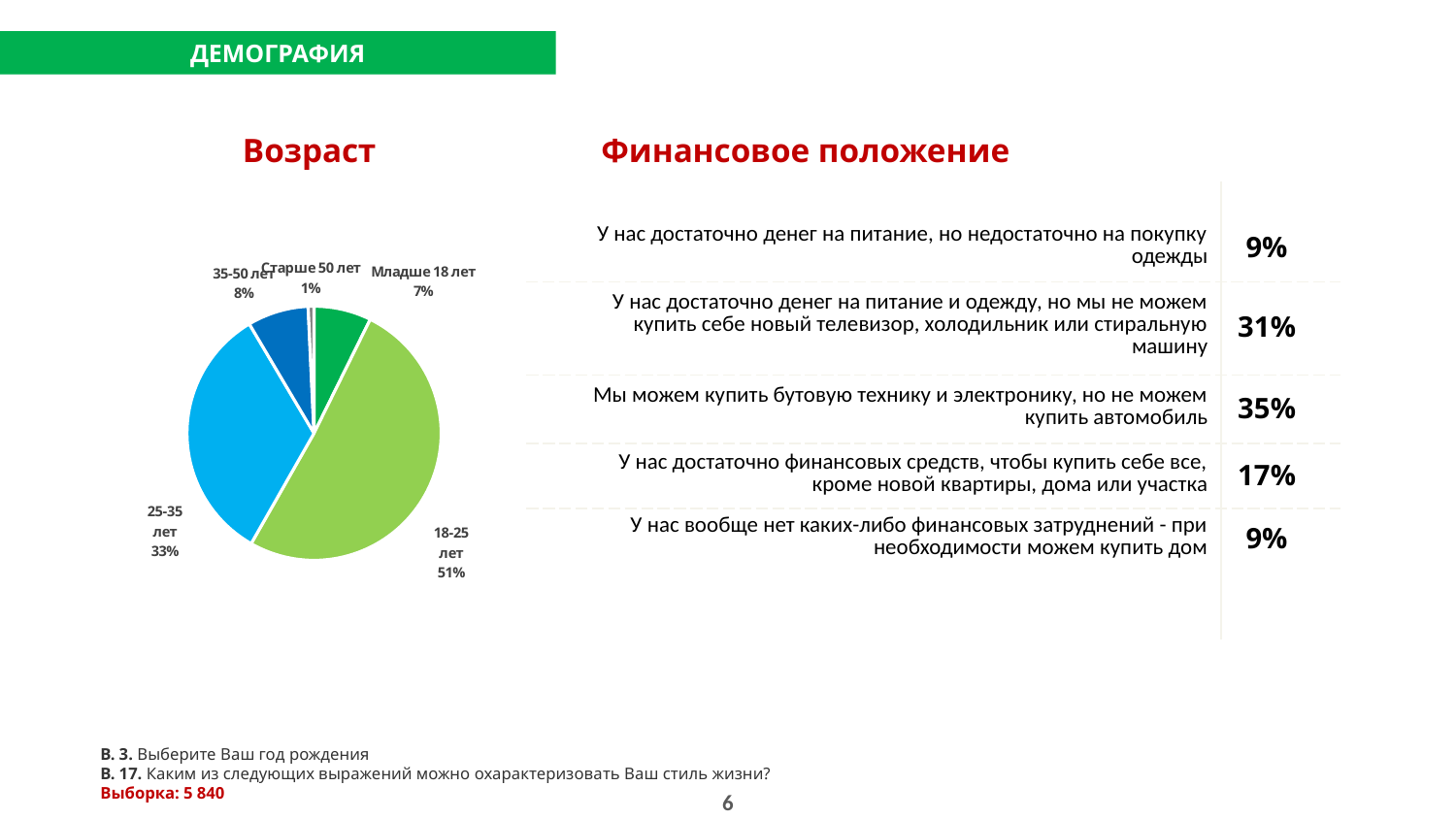
What type of chart is used for 'Возраст'? Pie chart In the 'Возраст' pie chart, what is the difference in percentage points between the 18-25 лет and 25-35 лет slices? 18 What is the title of the pie chart on the left of the slide? Возраст In the 'Возраст' pie chart, what share is the 35-50 лет slice? 8% In the 'Возраст' pie chart, which age group has the largest share? 18-25 лет In the 'Возраст' pie chart, which age group has the smallest share? Старше 50 лет How many slices does the 'Возраст' pie chart have? 5 In the 'Возраст' pie chart, which slice is larger: 35-50 лет or Младше 18 лет? 35-50 лет In the 'Возраст' pie chart, what share is the Младше 18 лет slice? 7% In the 'Возраст' pie chart, what share is the 25-35 лет slice? 33% In the 'Возраст' pie chart, what share is the 18-25 лет slice? 51% In the 'Возраст' pie chart, what share is the Старше 50 лет slice? 1%